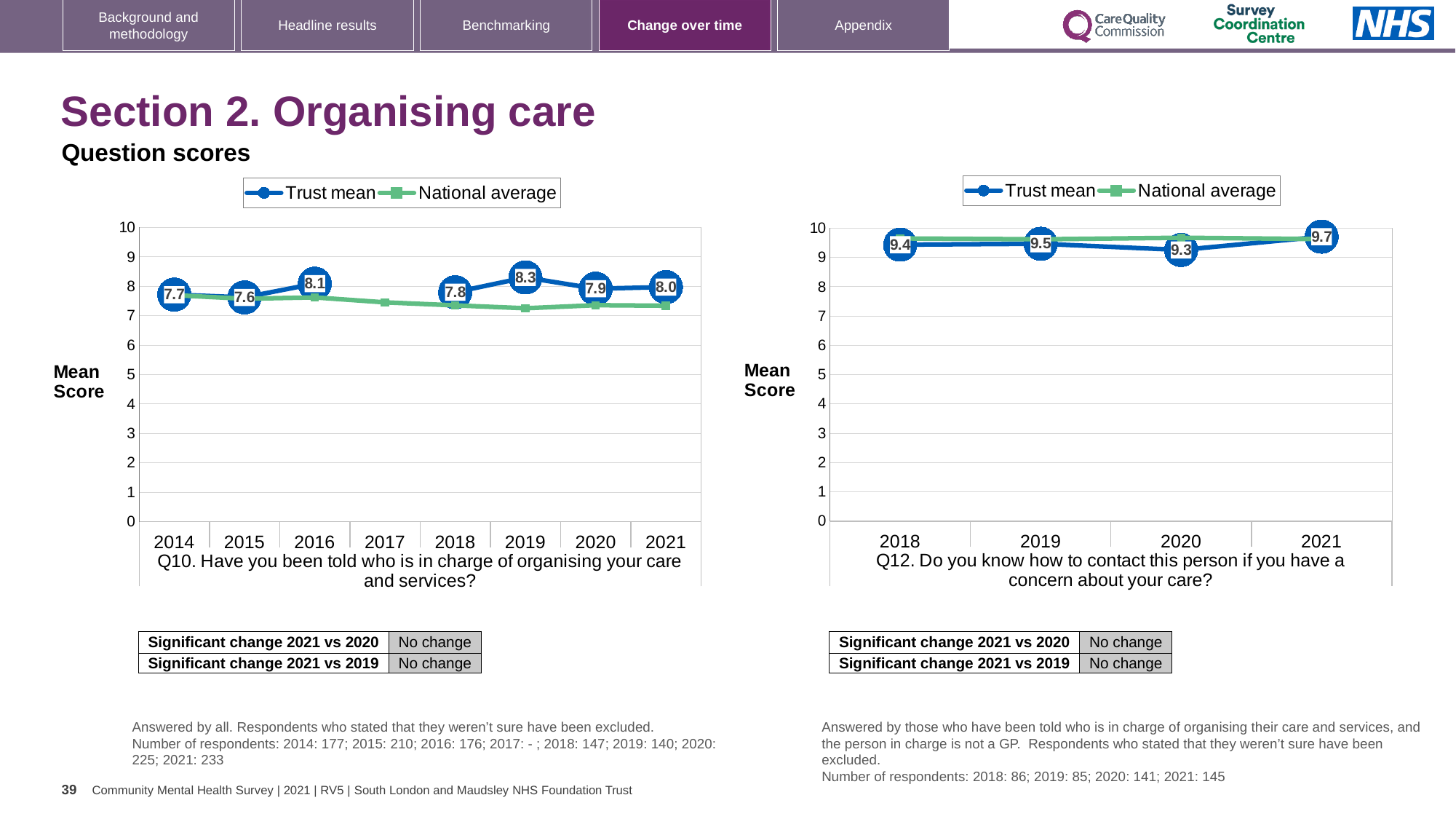
How many years are shown on the x axis of the Q12 chart on the right? 4 In the Q10 chart on the left, what is the difference between the Trust mean in 2019 and in 2015? 0.7 In the Q10 chart on the left, which year has the highest Trust mean? 2019 In the Q10 chart on the left, is the Trust mean for 2021 greater or less than 7? greater In the Q12 chart on the right, what is the Trust mean for 2021? 9.7 In the Q12 chart on the right, is the Trust mean larger in 2021 or in 2020? 2021 In the Q10 chart on the left, what is the Trust mean for 2019? 8.3 How many series does the legend of the Q10 chart on the left list? 2 In the Q12 chart on the right, which year has the lowest Trust mean? 2020 In the Q10 chart on the left, what is the Trust mean for 2014? 7.7 In the Q12 chart on the right, what is the difference between the Trust mean in 2021 and in 2020? 0.4 In the Q10 chart on the left, which year has the lowest Trust mean? 2015